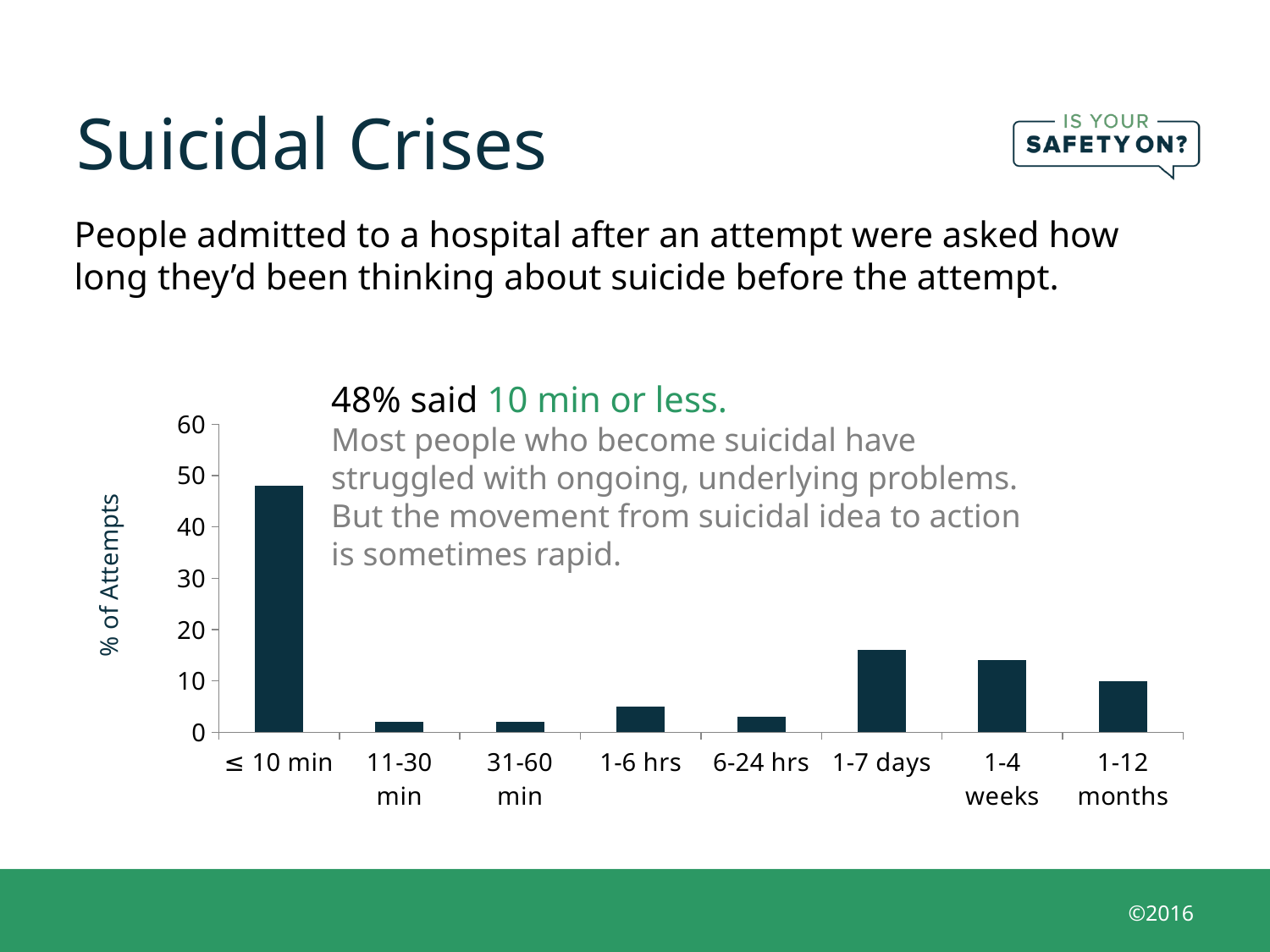
Is the value for "6-24 hrs" greater or less than 10? less What kind of chart is shown on the slide? bar chart Is the value for "1-6 hrs" greater or less than 10? less Is the value for "1-7 days" greater or less than 10? greater Which is larger, the value for "1-7 days" or the value for "1-12 months"? 1-7 days What percentage of attempts is shown for the "≤ 10 min" category? 48% What is the label on the vertical axis of the chart? % of Attempts Which is larger, the value for "≤ 10 min" or the value for "1-7 days"? ≤ 10 min Which category has the highest percentage of attempts? ≤ 10 min How many categories are shown on the x axis of the chart? 8